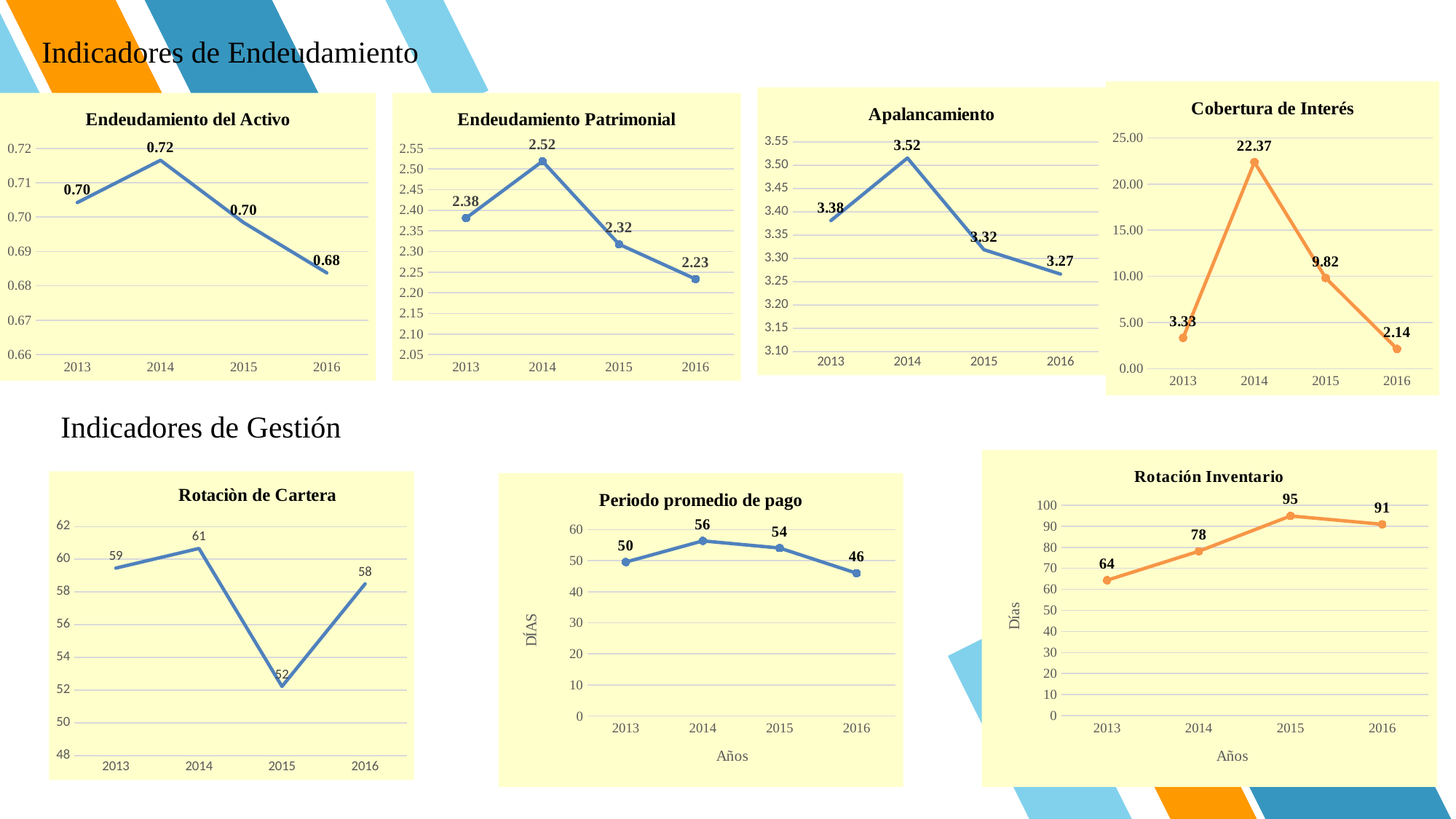
In the 'Cobertura de Interés' chart, is the value for 2015 greater or less than 10.00? less What is the y-axis label of the 'Periodo promedio de pago' chart? DÍAS In the 'Endeudamiento Patrimonial' chart, do the values rise or fall from 2014 to 2016? fall In the 'Periodo promedio de pago' chart, what is the difference between the 2014 value and the 2016 value? 10 In the 'Apalancamiento' chart, what is the difference between the 2014 value and the 2016 value? 0.25 In the 'Endeudamiento Patrimonial' chart, what is the value for 2016? 2.23 What kind of chart is 'Rotación Inventario'? line chart How many years are plotted in the 'Endeudamiento del Activo' chart? 4 In the 'Rotación Inventario' chart, which year has the highest value? 2015 In the 'Apalancamiento' chart, which is larger: the value for 2013 or the value for 2015? 2013 In the 'Rotaciòn de Cartera' chart, which year has the lowest value? 2015 In the 'Cobertura de Interés' chart, what is the value for 2014? 22.37